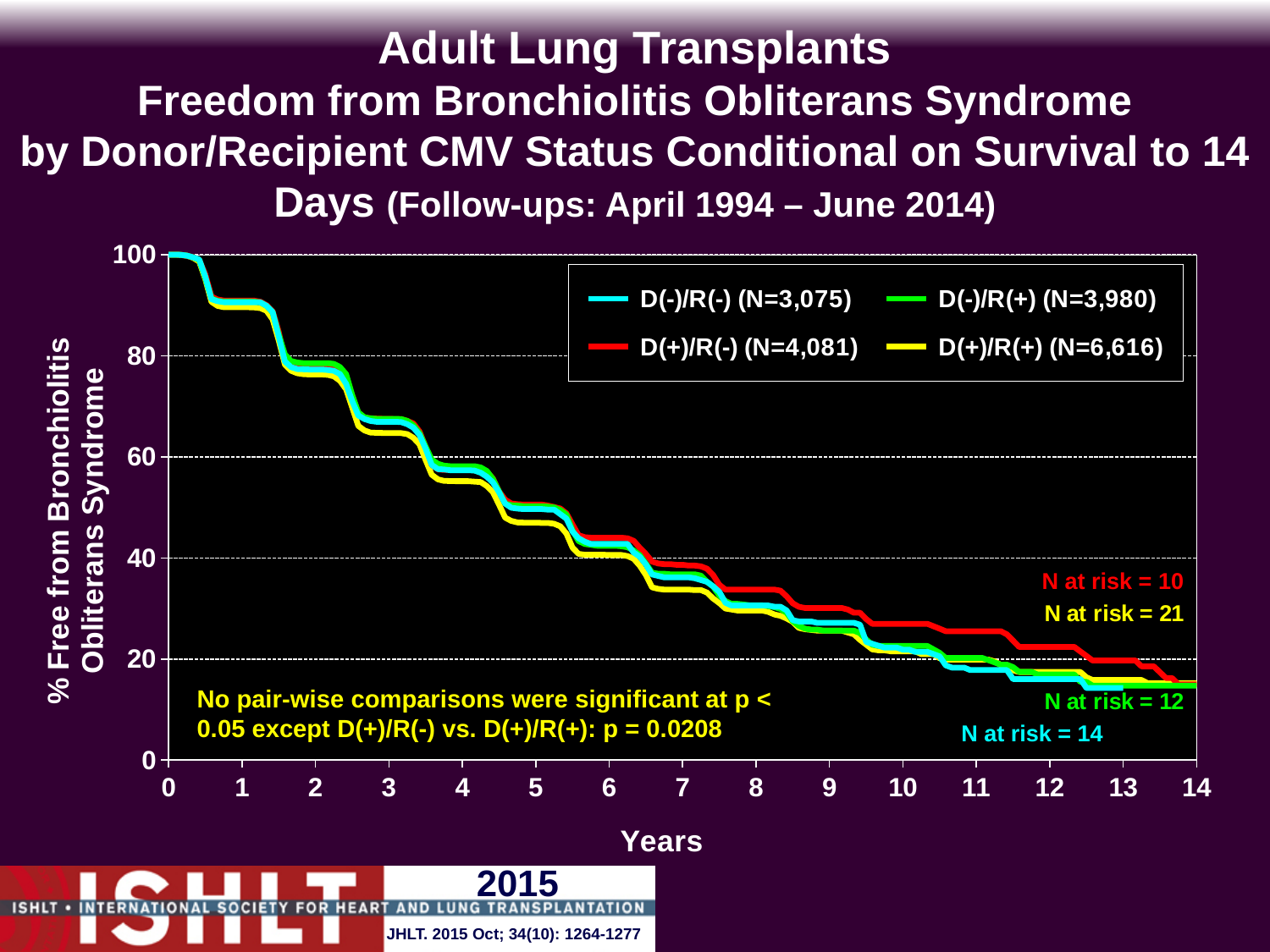
How many series does the legend list? 4 What kind of chart is shown on the slide? line chart What is the difference between the N for D(+)/R(+) and the N for D(-)/R(-)? 3,541 Which group has the smallest N in the legend? D(-)/R(-) Which curve is highest at year 12? D(+)/R(-) Do the curves rise or fall as years increase? fall What is the N for the D(+)/R(+) group shown in the legend? 6,616 Which group has the largest N in the legend? D(+)/R(+) Is the value for D(+)/R(-) at year 12 greater or less than 20? greater What is the N for the D(-)/R(-) group shown in the legend? 3,075 What is the label on the x axis? Years